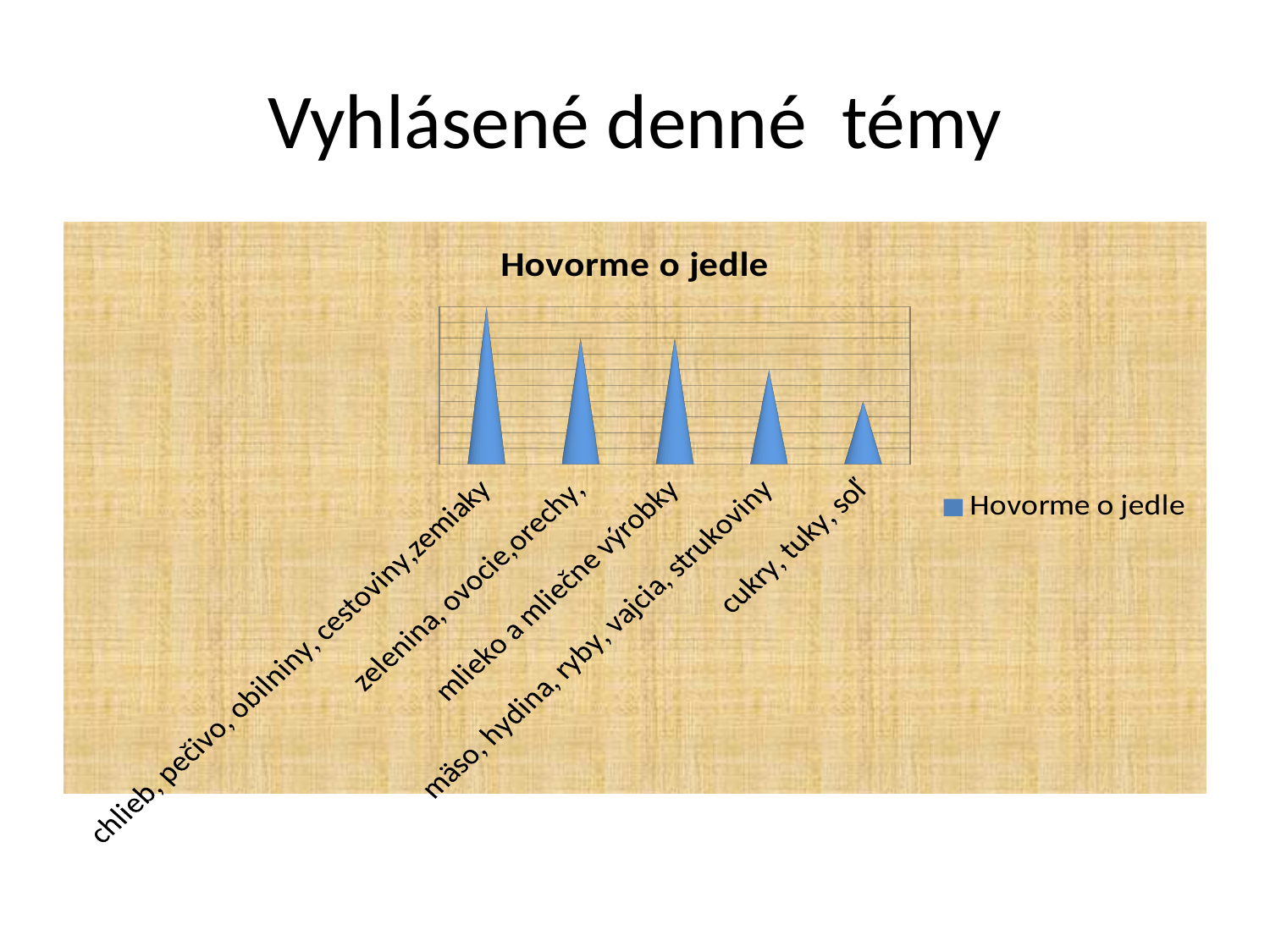
Which is larger: the value for "chlieb, pečivo, obilniny, cestoviny,zemiaky" or the value for "cukry, tuky, soľ"? chlieb, pečivo, obilniny, cestoviny,zemiaky Do the values rise or fall from left to right along the x axis? fall What is the title of the chart? Hovorme o jedle What is the name of the series shown in the legend? Hovorme o jedle Which is larger: the value for "zelenina, ovocie,orechy," or the value for "mäso, hydina, ryby, vajcia, strukoviny"? zelenina, ovocie,orechy, Which is larger: the value for "mäso, hydina, ryby, vajcia, strukoviny" or the value for "cukry, tuky, soľ"? mäso, hydina, ryby, vajcia, strukoviny Which category has the highest value? chlieb, pečivo, obilniny, cestoviny,zemiaky Which category has the lowest value? cukry, tuky, soľ How many series does the legend list? 1 What kind of chart is shown on the slide? bar chart How many categories are plotted in the chart? 5